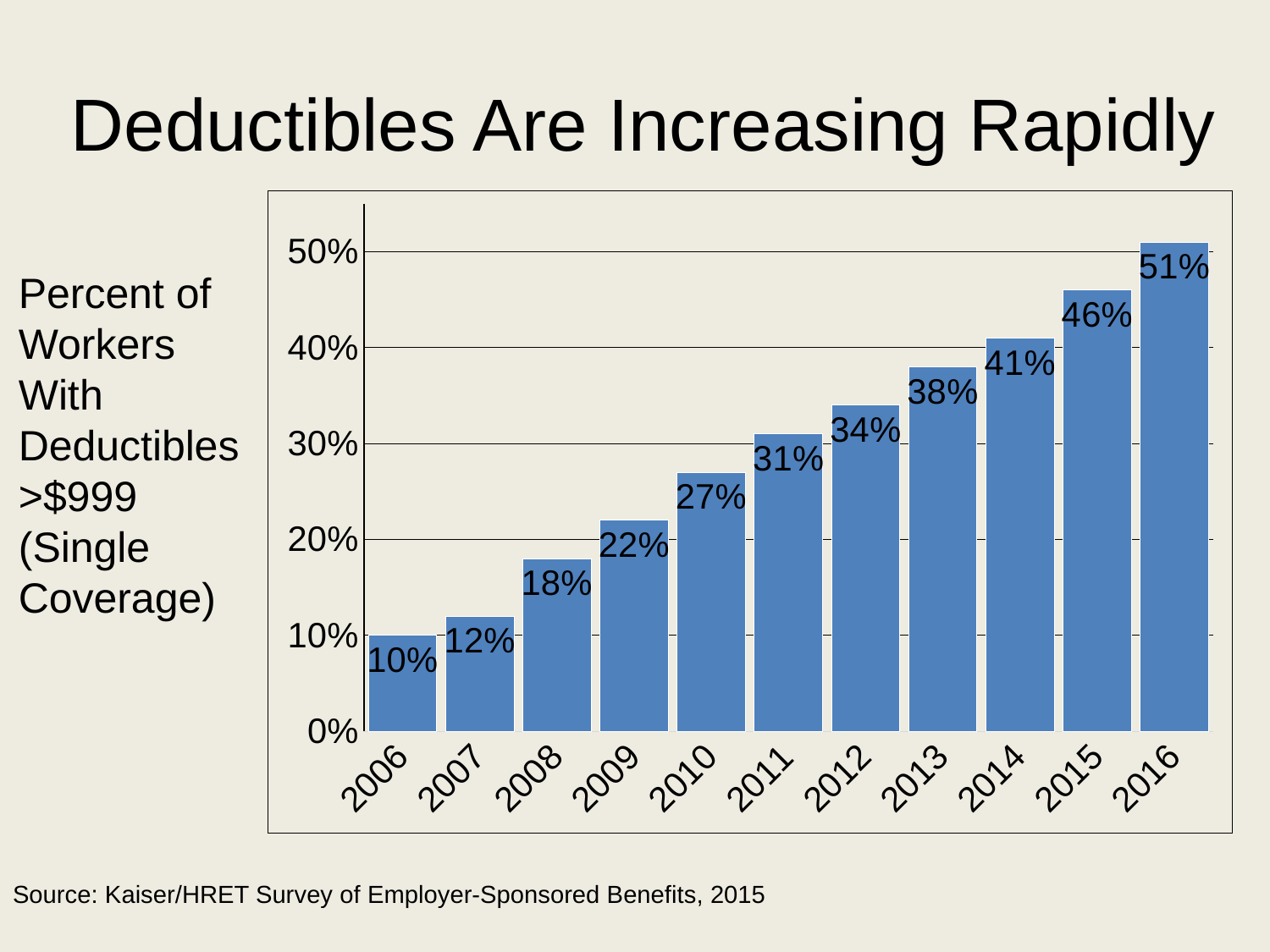
What is the value shown for 2006? 10% Do the values rise or fall from 2006 to 2016? Rise Which year has the highest value? 2016 What is the value shown for 2016? 51% Which year has the lowest value? 2006 How many years are shown on the x axis? 11 Which is larger, the value for 2009 or the value for 2011? 2011 What percent of workers had deductibles >$999 in 2010? 27% What kind of chart is shown on the slide? Bar chart What is the difference between the values for 2016 and 2006? 41% What is the difference between the values for 2013 and 2012? 4% Is the value for 2014 greater or less than 40%? greater